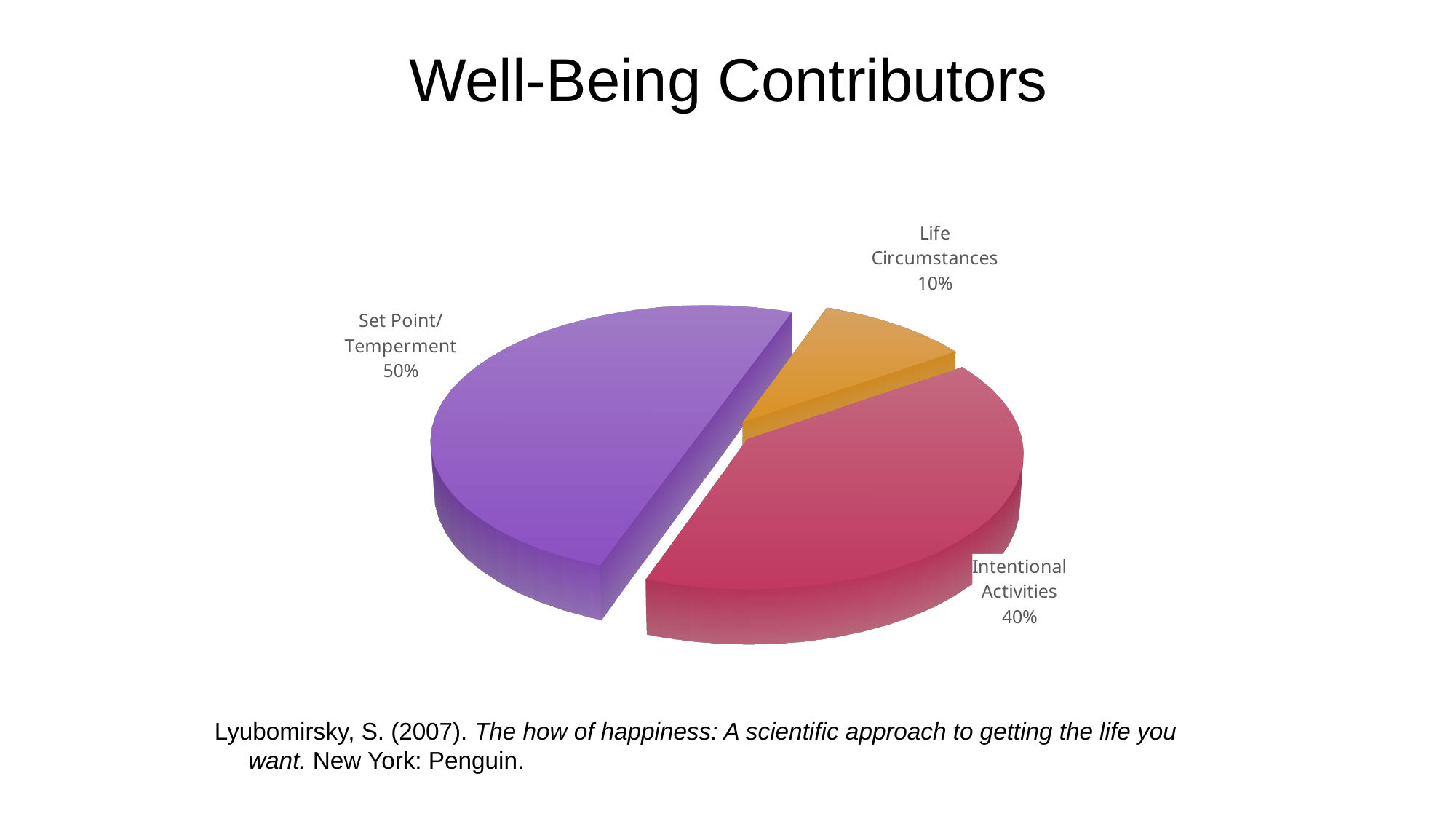
What is the difference in percentage points between Intentional Activities and Life Circumstances? 30 Which is larger, the Intentional Activities slice or the Life Circumstances slice? Intentional Activities Which category has the largest slice of the pie? Set Point/Temperment What colour is the Set Point/Temperment slice? Purple What is the difference in percentage points between Set Point/Temperment and Intentional Activities? 10 What kind of chart is shown on the slide? Pie chart What share of the pie is Set Point/Temperment? 50% Which category has the smallest slice of the pie? Life Circumstances What share of the pie is Life Circumstances? 10% How many slices does the pie chart have? 3 What is the title of the chart on the slide? Well-Being Contributors What share of the pie is Intentional Activities? 40%